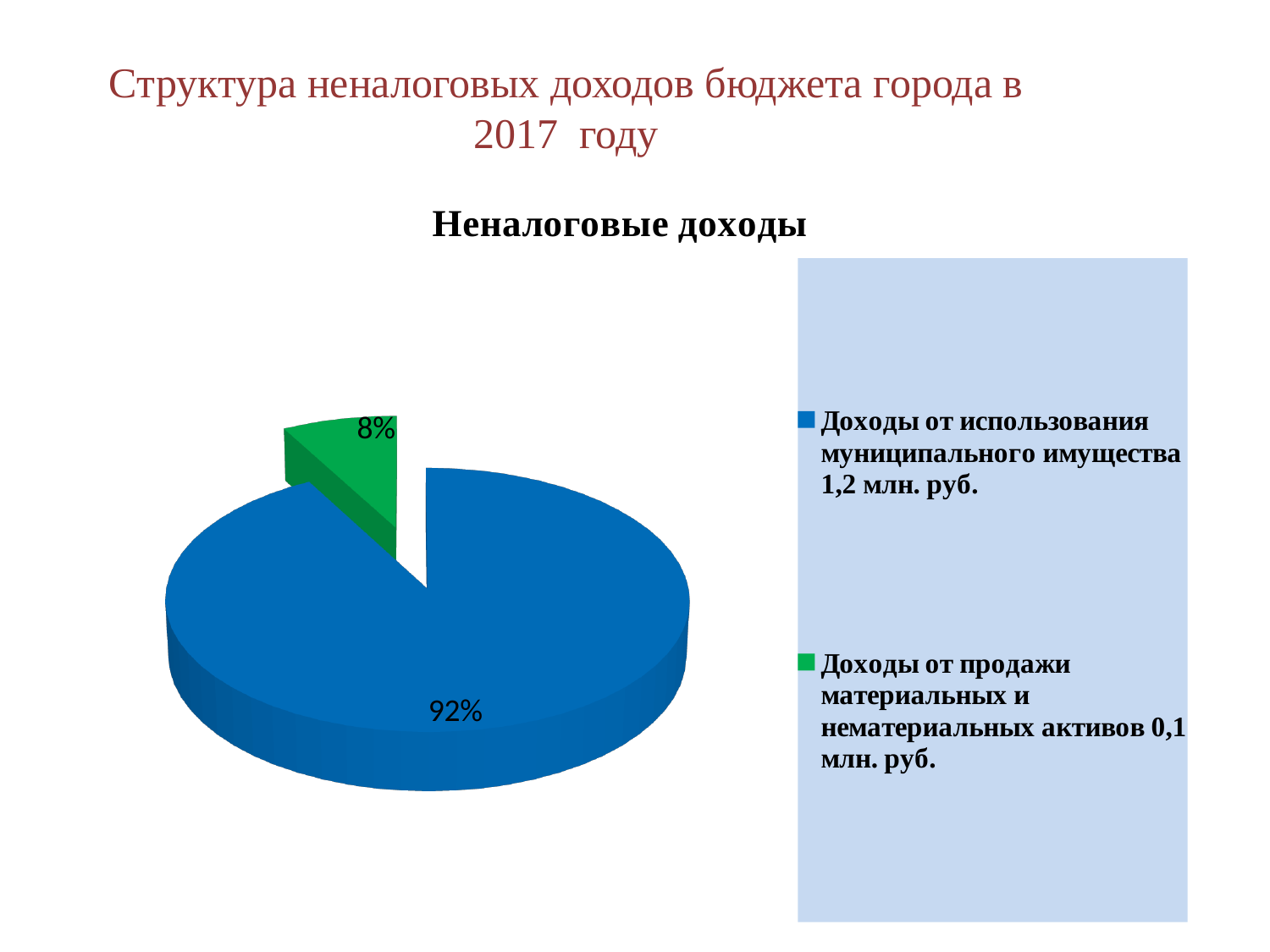
What share of the pie does 'Доходы от использования муниципального имущества' take? 92% What share of the pie does 'Доходы от продажи материальных и нематериальных активов' take? 8% Which category has the smallest slice of the pie? Доходы от продажи материальных и нематериальных активов What colour is the slice for 'Доходы от продажи материальных и нематериальных активов'? Green What amount in million rubles does the legend give for 'Доходы от продажи материальных и нематериальных активов'? 0,1 млн. руб. What amount in million rubles does the legend give for 'Доходы от использования муниципального имущества'? 1,2 млн. руб. What is the title of the chart? Неналоговые доходы Which is larger: the slice for 'Доходы от использования муниципального имущества' or the slice for 'Доходы от продажи материальных и нематериальных активов'? Доходы от использования муниципального имущества How many slices does the pie chart have? 2 What is the difference in percentage points between the two slices of the pie? 84 What kind of chart is shown on the slide? Pie chart Which category has the largest slice of the pie? Доходы от использования муниципального имущества